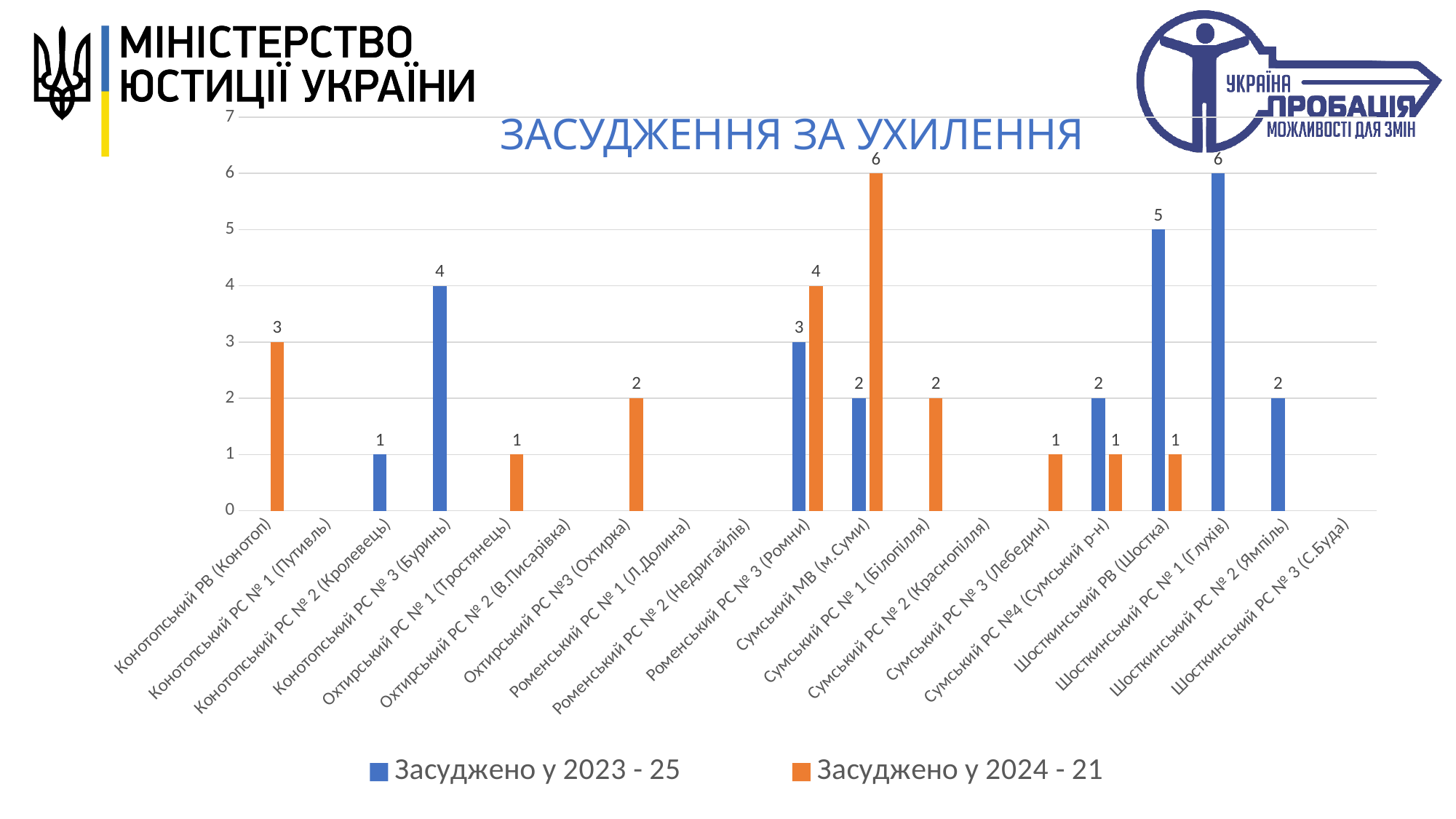
Which category has the highest value for 'Засуджено у 2023 - 25'? Шосткинський РС № 1 (Глухів) What is the value of 'Засуджено у 2023 - 25' for Конотопський РС № 3 (Буринь)? 4 Which colour represents the series 'Засуджено у 2024 - 21'? orange What is the difference between 'Засуджено у 2024 - 21' and 'Засуджено у 2023 - 25' for Сумський МВ (м.Суми)? 4 What is the value of 'Засуджено у 2023 - 25' for Шосткинський РВ (Шостка)? 5 How many categories are shown on the x axis? 19 For Роменський РС № 3 (Ромни), which series has the larger value: 'Засуджено у 2023 - 25' or 'Засуджено у 2024 - 21'? Засуджено у 2024 - 21 What type of chart is shown on the slide? bar chart What is the value of 'Засуджено у 2024 - 21' for Сумський МВ (м.Суми)? 6 What is the title of the chart? ЗАСУДЖЕННЯ ЗА УХИЛЕННЯ Which category has the highest value for 'Засуджено у 2024 - 21'? Сумський МВ (м.Суми) How many series does the legend list? 2